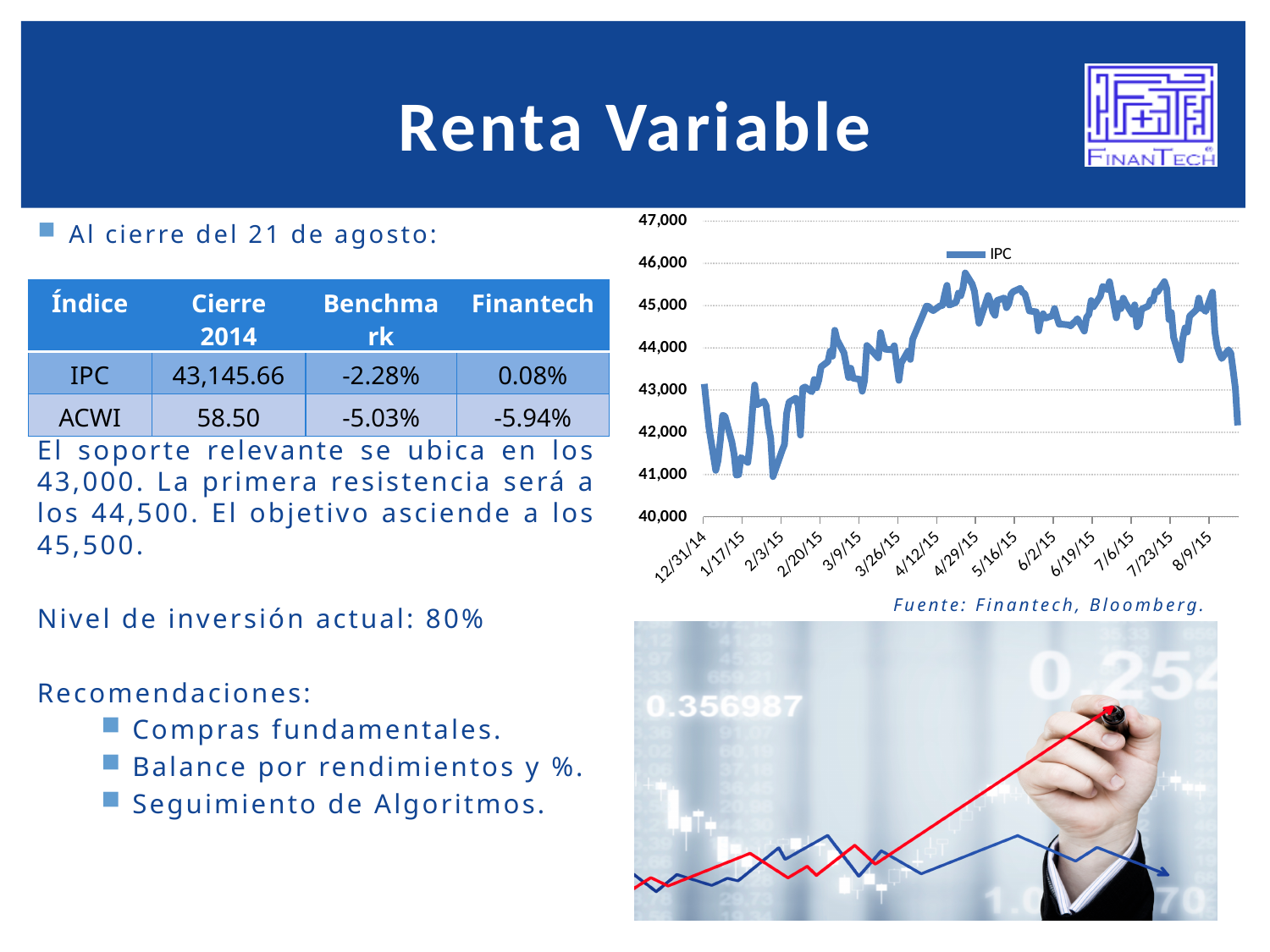
Does the IPC line rise or fall between 7/23/15 and the end of the chart? fall Is the IPC value at the last point of the chart greater or less than 43,000? less What is the highest value shown on the chart's vertical axis? 47,000 Is the IPC value around 1/17/15 greater or less than 43,000? less What kind of chart is shown on the slide? line chart How many series does the chart's legend list? 1 How many date labels are shown along the chart's x axis? 14 Is the IPC value around 6/2/15 greater or less than 44,000? greater Does the IPC line generally rise or fall between 1/17/15 and 4/29/15? rise What series name appears in the chart's legend? IPC